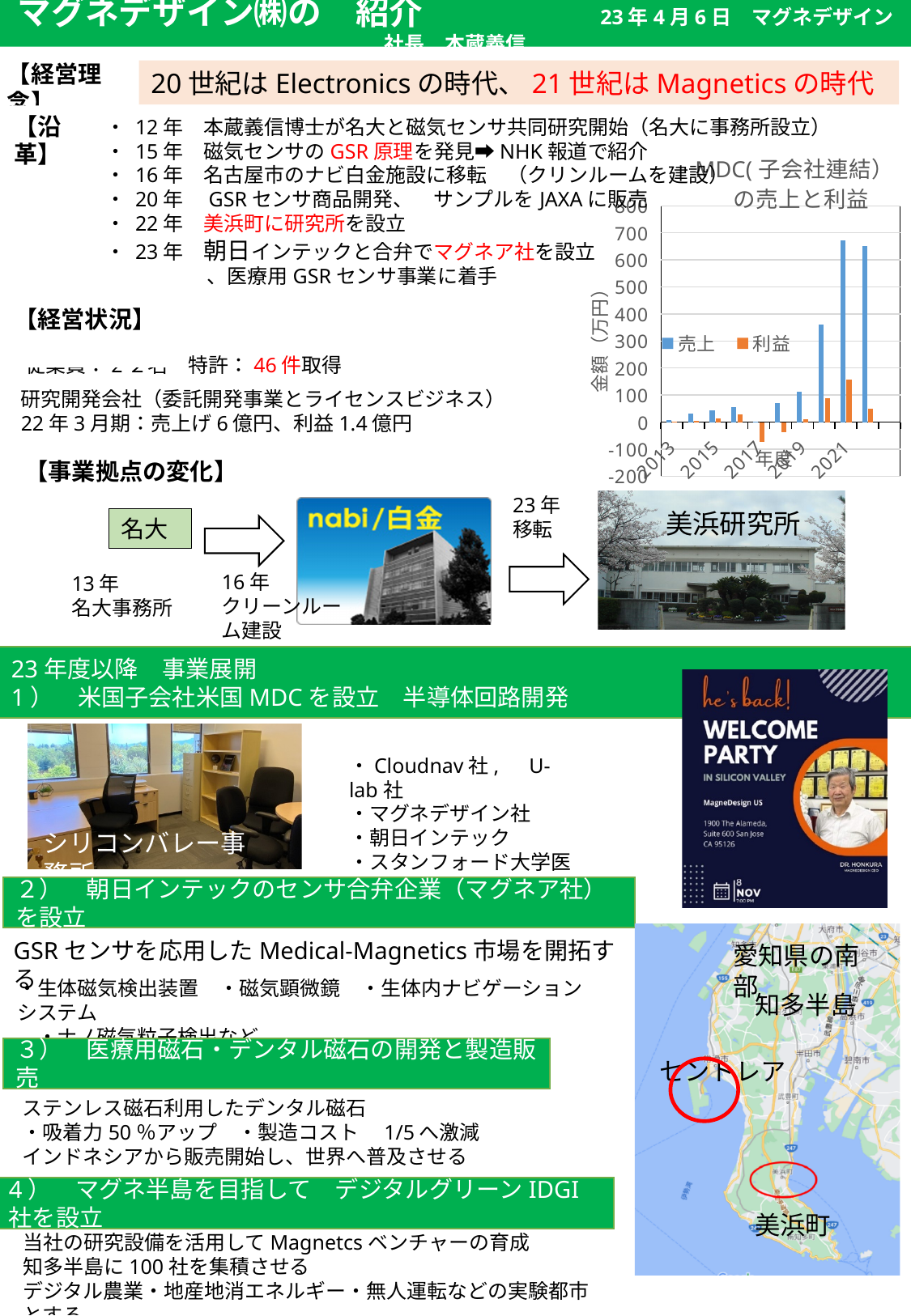
What kind of chart is shown on the slide? bar chart Is the 売上 value for 2015 greater or less than 100? less Do the 売上 values generally rise or fall from 2013 to 2021? rise How many series does the legend of the chart list? 2 Is the 利益 value for 2017 greater or less than 0? less Is the 利益 value for 2021 greater or less than 100? greater Which year has the lowest 利益 value in the chart? 2017 What are the two series named in the chart legend? 売上 and 利益 Which is larger, the 売上 value for 2021 or the 売上 value for 2015? 2021 What is the title of the chart? MDC(子会社連結)の売上と利益